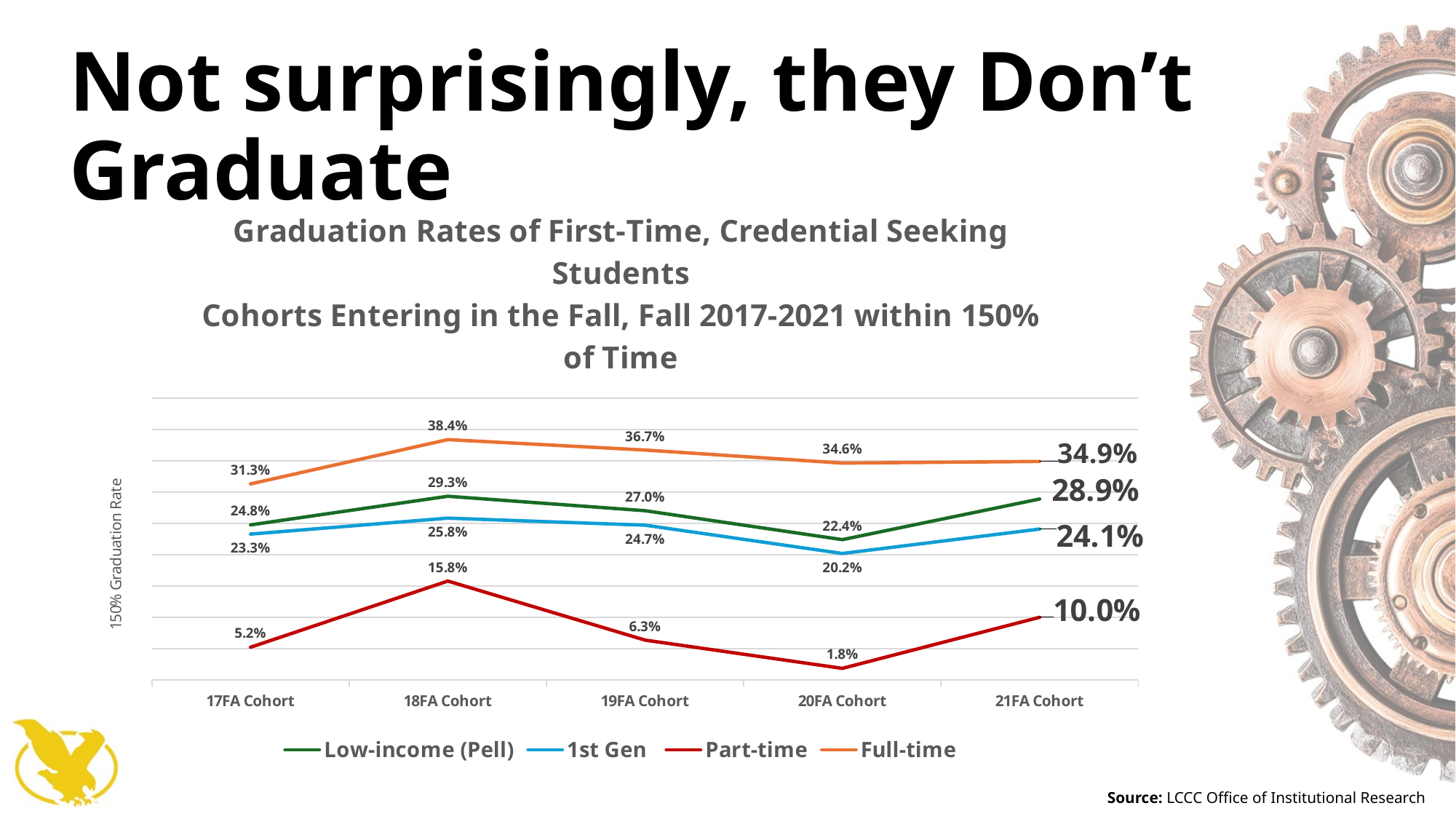
What is the 1st Gen graduation rate for the 21FA Cohort? 24.1% Which cohort has the lowest Low-income (Pell) graduation rate? 20FA Cohort Which is larger for the 17FA Cohort, the Low-income (Pell) rate or the 1st Gen rate? Low-income (Pell) Which series is drawn in red? Part-time What is the Part-time graduation rate for the 20FA Cohort? 1.8% How many series does the legend list? 4 Which cohort has the highest Part-time graduation rate? 18FA Cohort How many cohorts are shown on the x axis? 5 What is the difference between the Full-time and Part-time graduation rates for the 21FA Cohort? 24.9% What is the Low-income (Pell) graduation rate for the 19FA Cohort? 27.0% What type of chart is shown on the slide? line chart What is the Full-time graduation rate for the 18FA Cohort? 38.4%